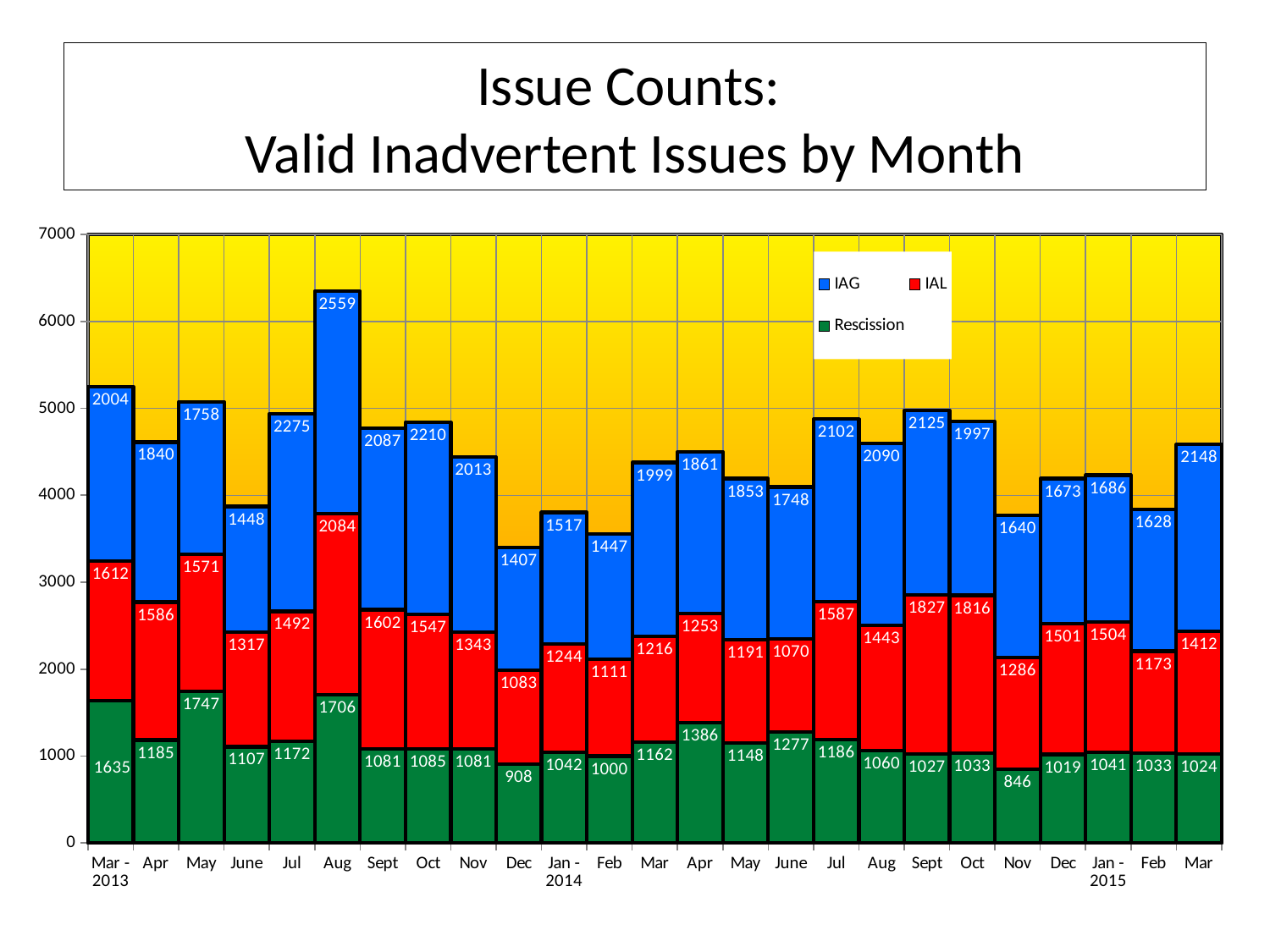
Which month has the highest IAG value? Aug 2013 Which series is shown in green in the legend? Rescission Which month has the lowest Rescission value? Nov 2014 What is the difference between the IAL values for Aug 2013 and Dec 2013? 1001 Which is larger, the IAG value for Mar 2015 or the IAG value for Feb 2015? Mar 2015 What is the total of the stacked bar for Dec 2013? 3398 How many series does the legend list? 3 What is the Rescission value for Nov 2014? 846 How many monthly bars are plotted in the chart? 25 What is the IAG value for Aug 2013? 2559 What is the IAL value for Sept 2014? 1827 What type of chart is shown on the slide? stacked bar chart